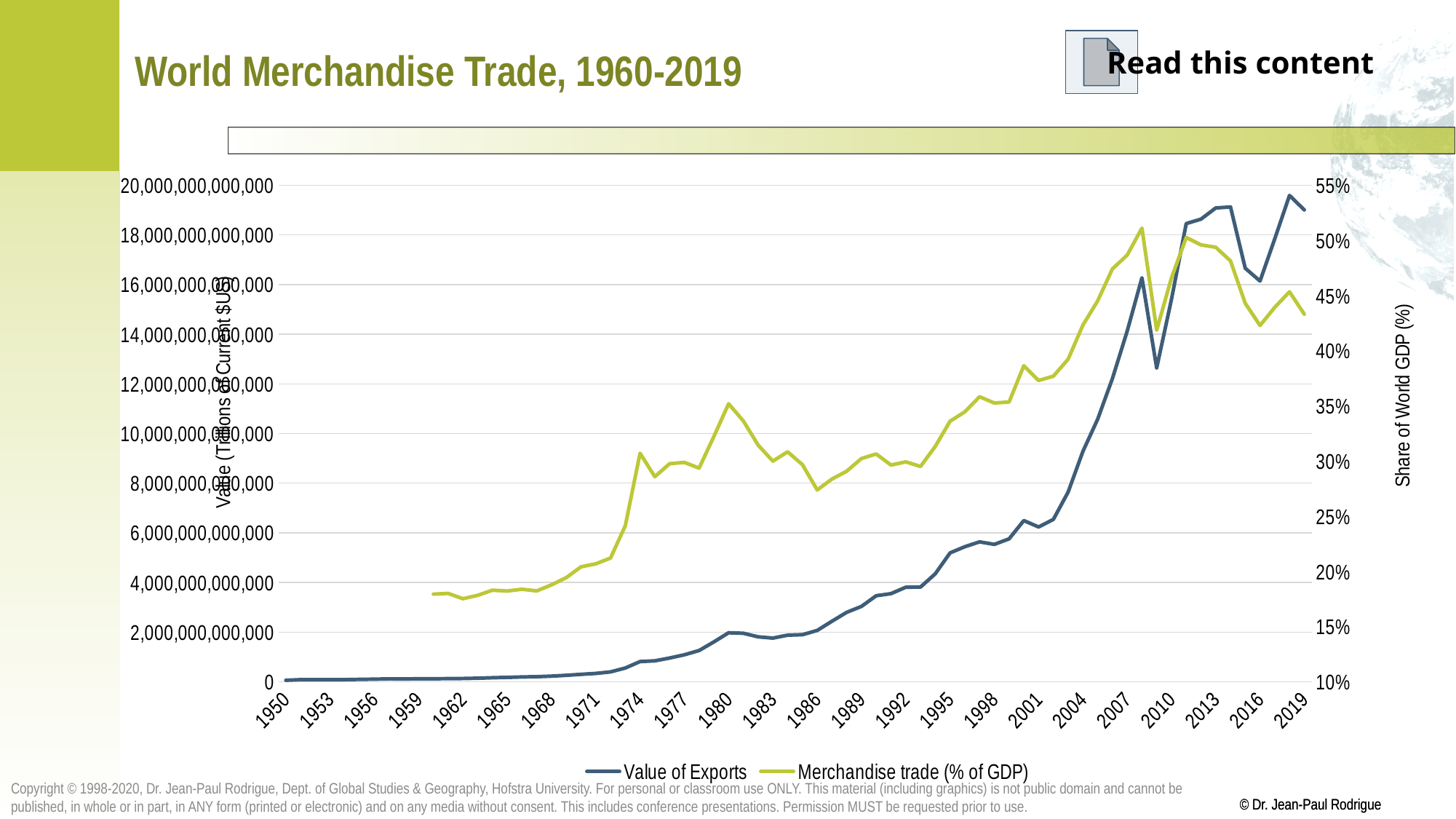
Is the Merchandise trade (% of GDP) value in 1986 greater or less than 30%? less What kind of chart is shown on the slide? Line chart Is the Value of Exports in 2007 greater or less than 12,000,000,000,000? greater Is the Value of Exports in 2019 greater or less than 18,000,000,000,000? greater Which two series are listed in the legend? Value of Exports; Merchandise trade (% of GDP) What is the title of the chart? World Merchandise Trade, 1960-2019 Does the Value of Exports generally rise or fall from 1950 to 2007? rise Which is larger, the Value of Exports in 2019 or in 2010? 2019 How many series does the legend list? 2